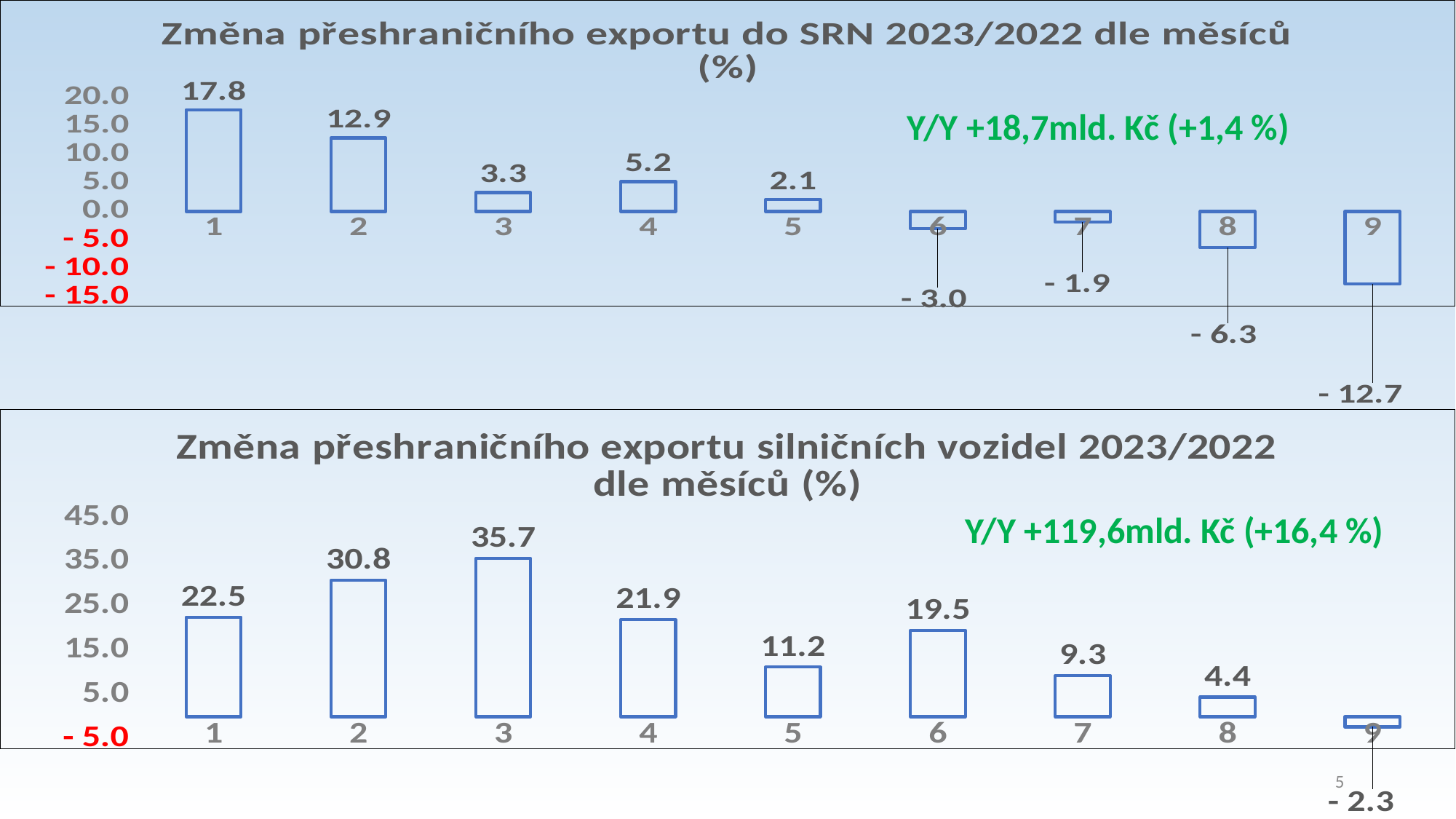
In the top chart (export to SRN), which month has the highest value? 1 In the top chart (export to SRN), what is the value for month 9? -12.7 In the top chart (export to SRN), how many months are plotted? 9 In the top chart (export to SRN), what is the value for month 1? 17.8 In the bottom chart (export of road vehicles), do the values generally rise or fall from month 3 to month 9? fall In the top chart (export to SRN), which month has the lowest value? 9 In the bottom chart (export of road vehicles), what is the difference between the values for month 3 and month 2? 4.9 In the bottom chart (export of road vehicles), which month has the lowest value? 9 In the bottom chart (export of road vehicles), which is larger, the value for month 4 or month 6? month 4 In the top chart (export to SRN), what is the difference between the values for month 1 and month 2? 4.9 In the bottom chart (export of road vehicles), what is the value for month 3? 35.7 What kind of chart is the bottom chart (export of road vehicles)? bar chart